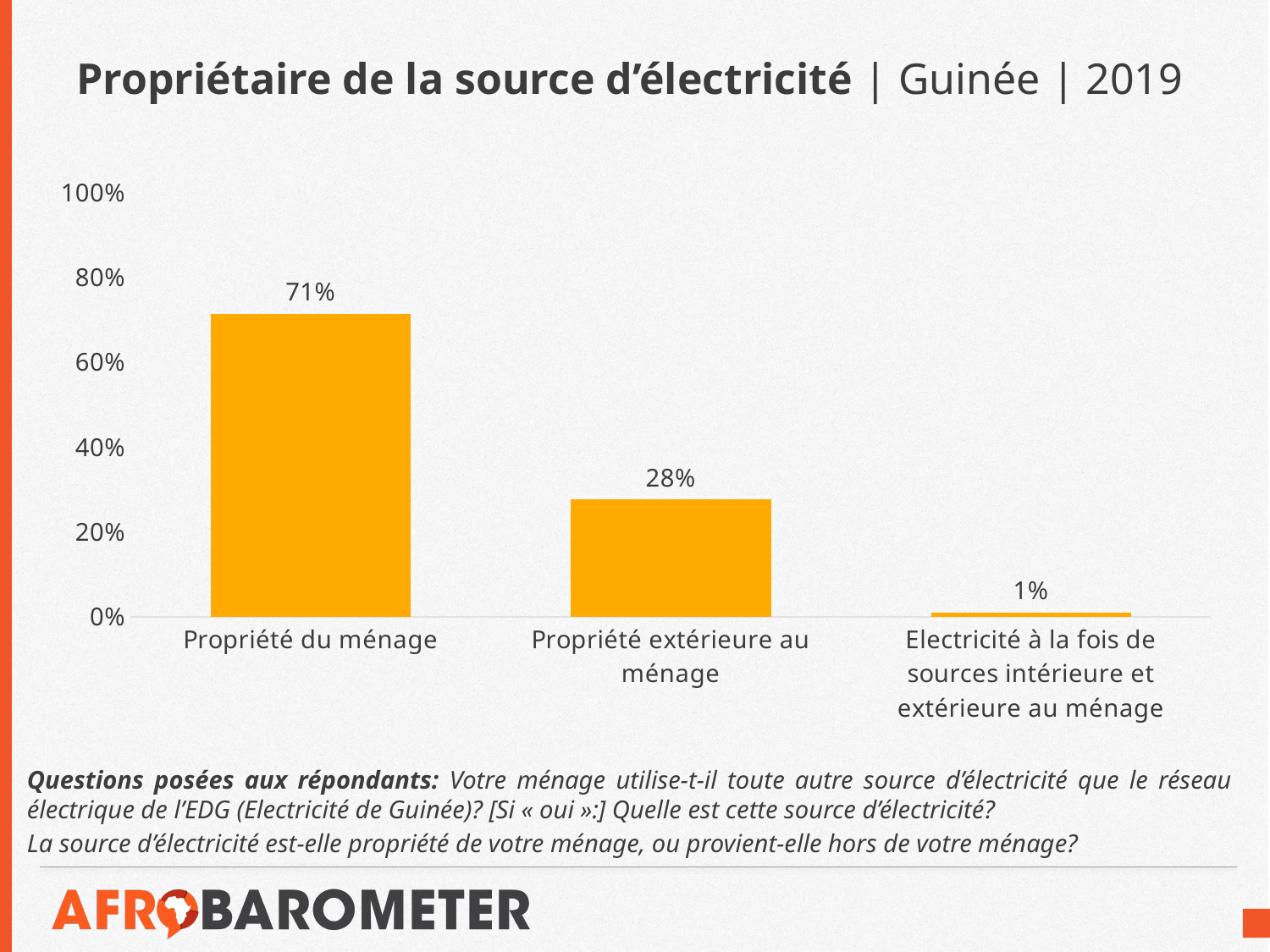
Is the value for "Propriété du ménage" greater or less than 60%? greater Which category has the lowest value? Electricité à la fois de sources intérieure et extérieure au ménage What is the value for "Electricité à la fois de sources intérieure et extérieure au ménage"? 1% What is the difference between the values for "Propriété du ménage" and "Propriété extérieure au ménage"? 43 percentage points Which is larger: the value for "Propriété extérieure au ménage" or the value for "Electricité à la fois de sources intérieure et extérieure au ménage"? Propriété extérieure au ménage Is the value for "Propriété extérieure au ménage" greater or less than 40%? less Which category has the highest value? Propriété du ménage What kind of chart is shown on the slide? Bar chart How many categories are shown on the chart? 3 What is the title of the chart? Propriétaire de la source d'électricité | Guinée | 2019 What is the value for "Propriété du ménage"? 71% What is the value for "Propriété extérieure au ménage"? 28%